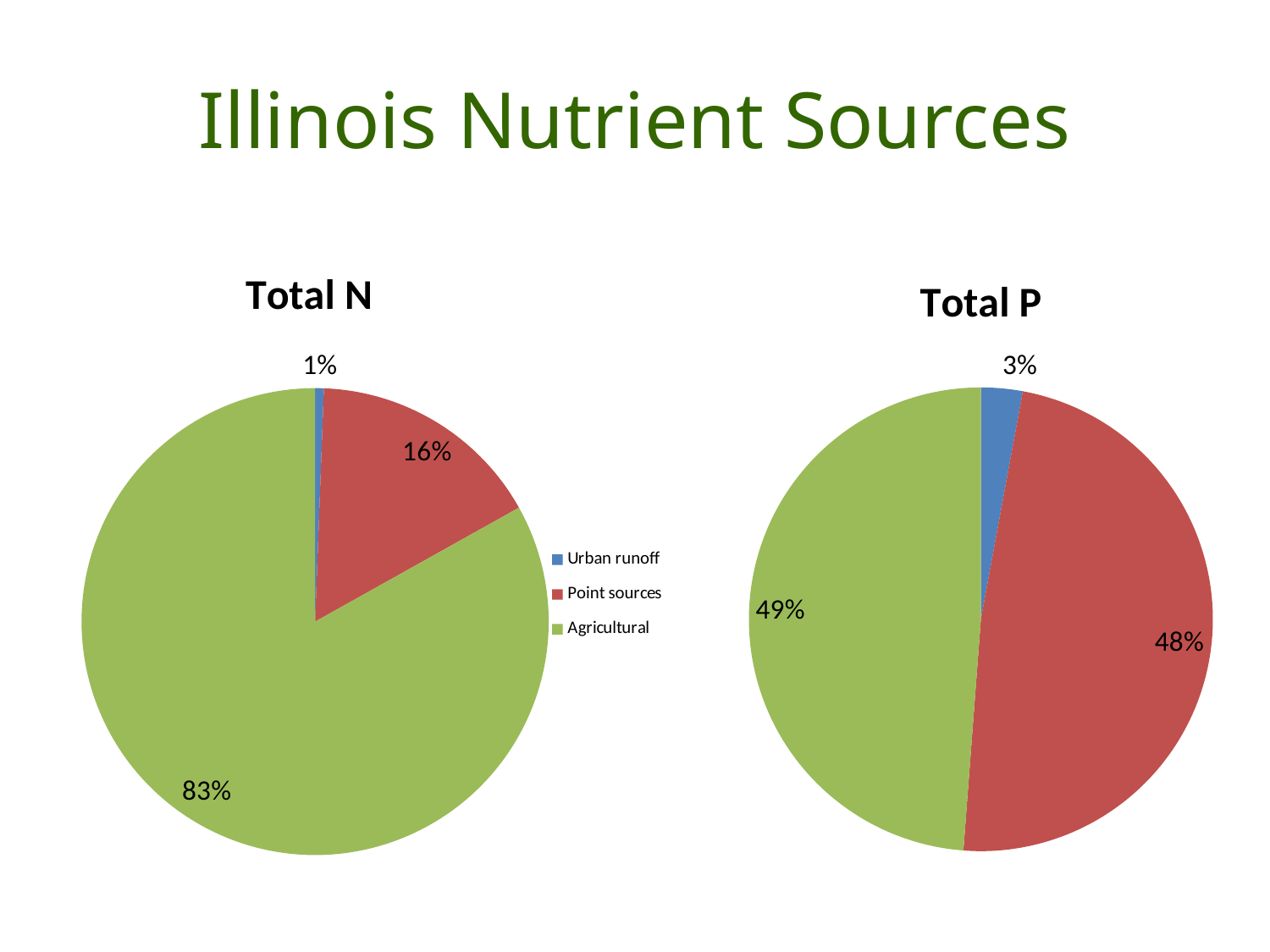
In the Total N chart, what is the value for Point sources? 16% In the Total N chart, what share of the pie is Agricultural? 83% In the Total N chart, which category has the largest slice? Agricultural In the Total P chart, which category has the smallest slice? Urban runoff In the Total P chart, what is the value for Point sources? 48% In the Total P chart, what is the value for Urban runoff? 3% In the Total P chart, what share of the pie is Agricultural? 49% What kind of chart is the Total P chart? Pie chart In the Total N chart, which category has the smallest slice? Urban runoff In the Total N chart, what is the difference between the Agricultural and Point sources shares? 67% In the Total N chart, what is the value for Urban runoff? 1% How many categories does the legend list? 3